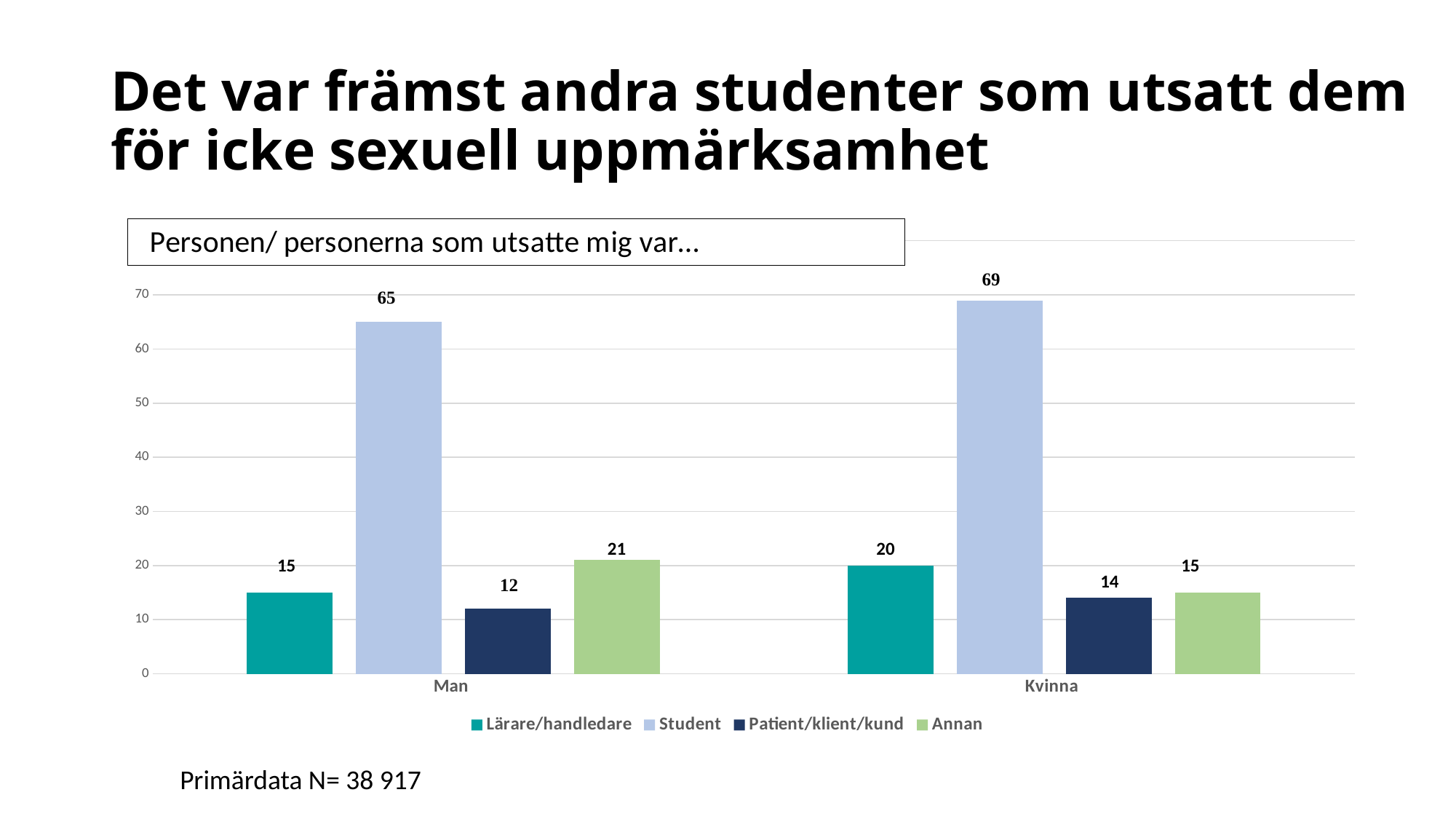
What is the value for Patient/klient/kund in the Kvinna category? 14 What is the value for Annan in the Man category? 21 Which series has the lowest value in the Man category? Patient/klient/kund Which series has the highest value in the Kvinna category? Student What kind of chart is shown on the slide? Bar chart Which is larger: Annan for Man or Annan for Kvinna? Annan for Man How many series does the legend list? 4 What is the difference between the Student values for Kvinna and Man? 4 What is the value for Lärare/handledare in the Kvinna category? 20 What is the value for Student in the Man category? 65 What is the title shown in the box above the chart? Personen/ personerna som utsatte mig var... How many categories are shown on the x axis? 2